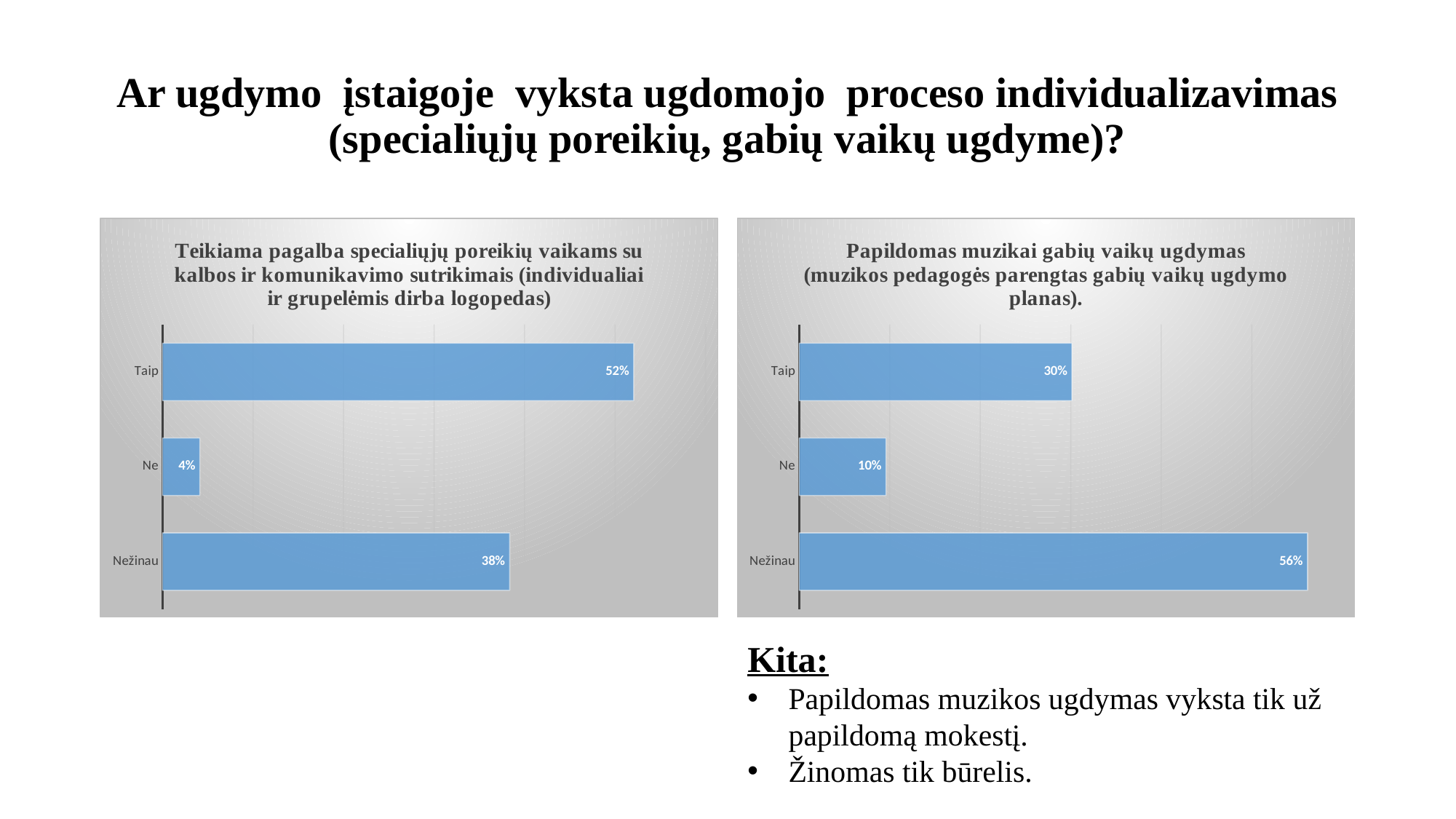
In the right chart (Papildomas muzikai gabių vaikų ugdymas), what is the value for Nežinau? 56% In the left chart (Teikiama pagalba specialiųjų poreikių vaikams...), what is the value for Taip? 52% In the right chart (Papildomas muzikai gabių vaikų ugdymas), what is the difference between the values for Nežinau and Taip? 26% In the left chart (Teikiama pagalba specialiųjų poreikių vaikams...), what is the value for Nežinau? 38% In the right chart (Papildomas muzikai gabių vaikų ugdymas), which category has the lowest value? Ne In the left chart (Teikiama pagalba specialiųjų poreikių vaikams...), which category has the highest value? Taip In the right chart (Papildomas muzikai gabių vaikų ugdymas), which is larger, the value for Taip or the value for Ne? Taip What kind of chart is the left chart (Teikiama pagalba specialiųjų poreikių vaikams...)? Bar chart In the right chart (Papildomas muzikai gabių vaikų ugdymas), which category has the highest value? Nežinau In the left chart (Teikiama pagalba specialiųjų poreikių vaikams...), what is the value for Ne? 4% In the left chart (Teikiama pagalba specialiųjų poreikių vaikams...), what is the difference between the values for Taip and Nežinau? 14% In the right chart (Papildomas muzikai gabių vaikų ugdymas), what is the value for Taip? 30%